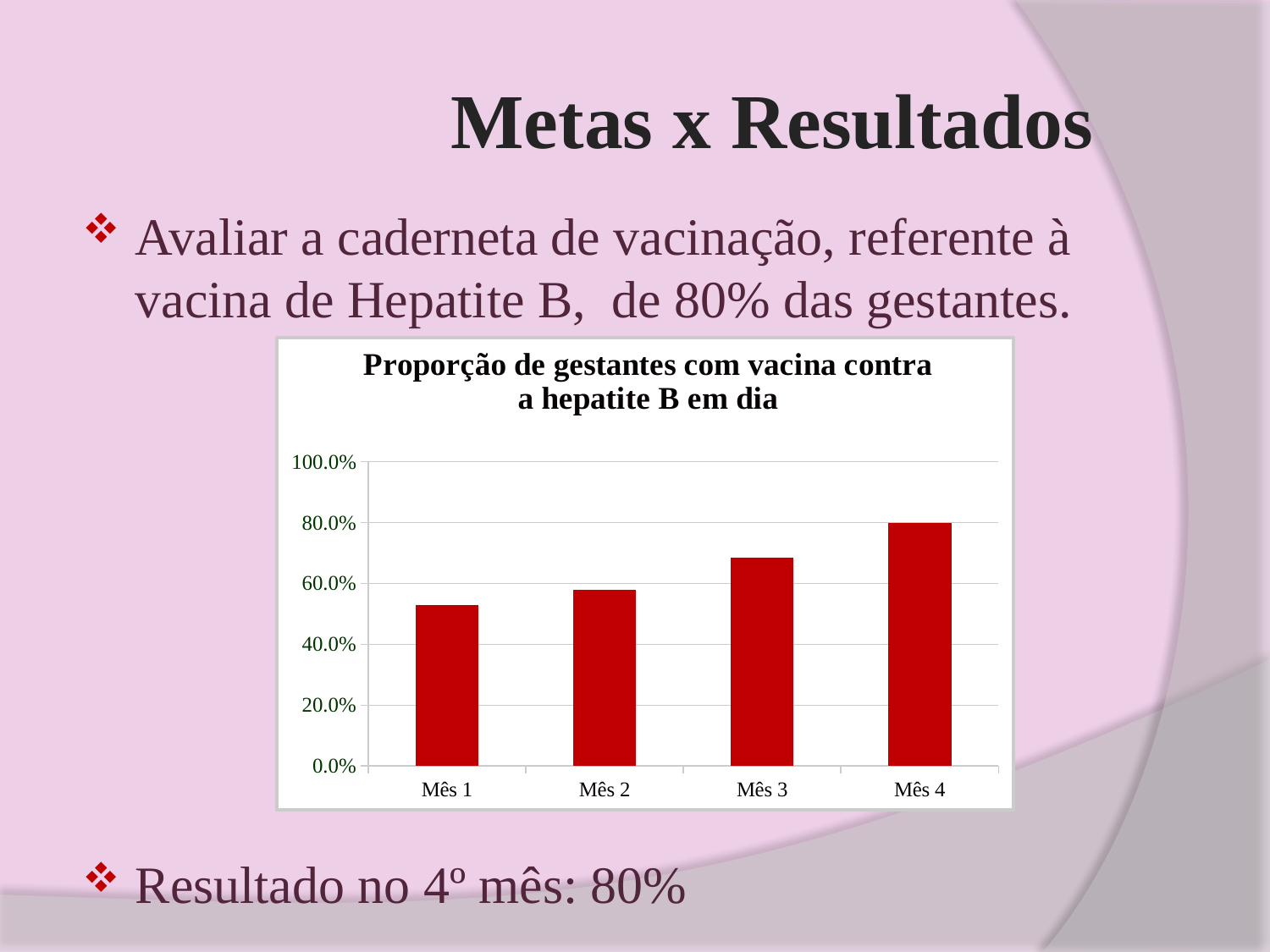
Which month has the highest proportion of pregnant women with hepatitis B vaccination up to date? Mês 4 Is the value for Mês 1 greater or less than 40.0%? greater How many categories (months) are plotted in the chart? 4 Do the values rise or fall from Mês 1 to Mês 4? rise Is the value for Mês 3 greater or less than 80.0%? less Which is larger, the value for Mês 2 or the value for Mês 3? Mês 3 Is the value for Mês 1 greater or less than 60.0%? less Which month has the lowest proportion in the chart? Mês 1 What is the value for Mês 4 in the chart? 80.0% What is the title of the chart? Proporção de gestantes com vacina contra a hepatite B em dia What kind of chart is shown on the slide? bar chart